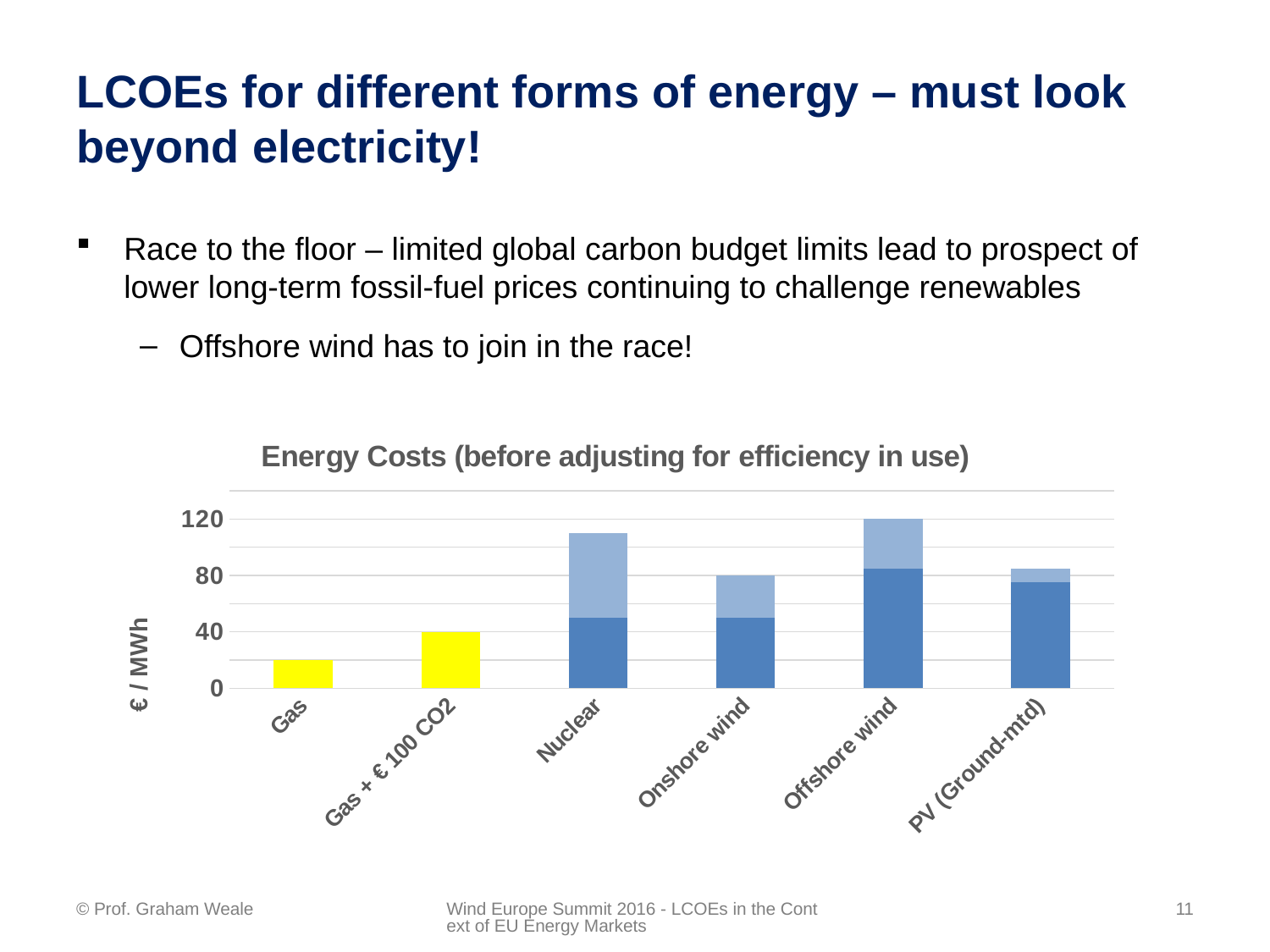
Which has a higher total energy cost, Nuclear or Onshore wind? Nuclear What kind of chart is shown on the slide? bar chart Which category has the highest total energy cost in the chart? Offshore wind Which category has the lowest energy cost in the chart? Gas How many energy categories are shown on the x axis of the chart? 6 What is the label on the vertical axis of the chart? € / MWh Is the total value for Nuclear greater or less than 120? less What is the total value of the Offshore wind bar, as read from the axis tick it reaches? 120 What is the title of the chart? Energy Costs (before adjusting for efficiency in use) Is the value for Gas greater or less than 40? less Is the total value for Nuclear greater or less than 80? greater Which has a higher energy cost, Gas or Gas + € 100 CO2? Gas + € 100 CO2